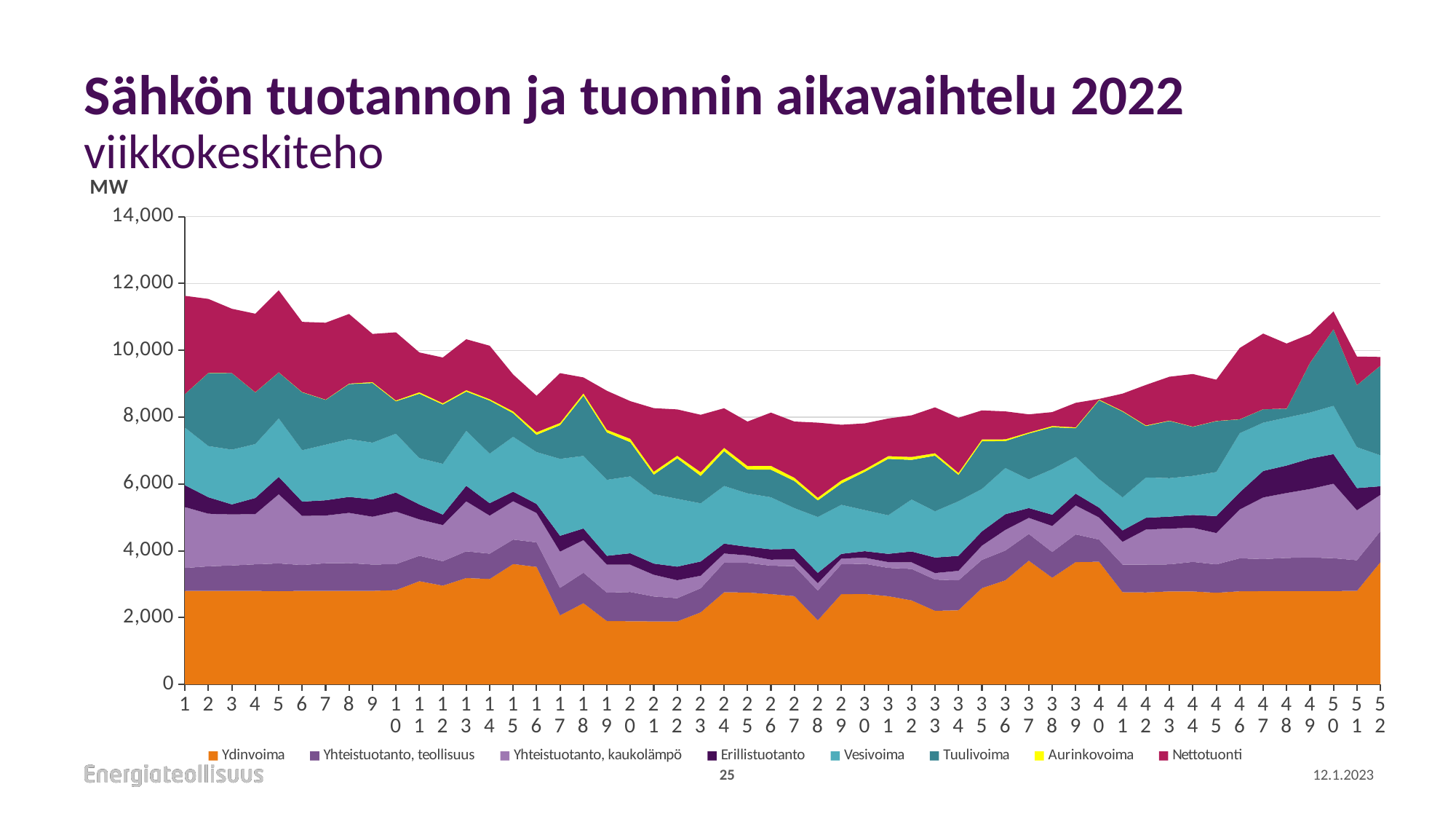
Is the total stacked value for week 20 greater or less than 10,000? less What kind of chart is shown on the slide? Stacked area chart Which is larger, the total stacked value for week 1 or for week 28? Week 1 What is the title of the chart? Sähkön tuotannon ja tuonnin aikavaihtelu 2022 viikkokeskiteho What unit is shown on the y axis? MW Is the Ydinvoima value for week 37 greater or less than 3,000? greater Is the total stacked value for week 50 greater or less than 10,000? greater Does the total stacked value rise or fall from week 1 to week 28? fall How many weeks are plotted along the x axis? 52 How many series does the legend list? 8